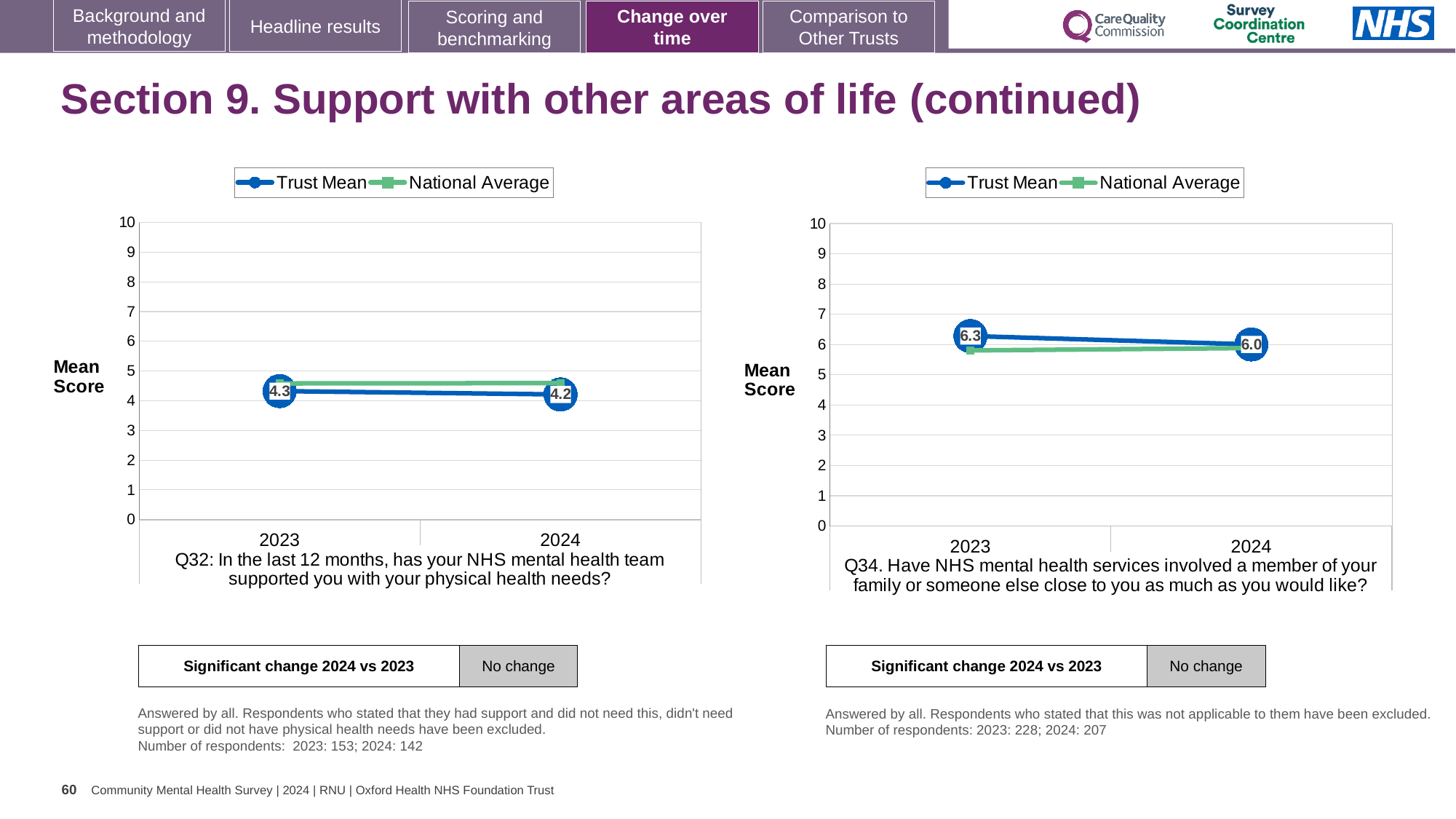
What kind of chart is the Q32 chart on the left? line chart How many years are shown on the x axis of the Q32 chart on the left? 2 In the Q34 chart on the right, by how much did the Trust Mean change from 2023 to 2024? 0.3 How many series does the legend of the Q34 chart on the right list? 2 In the Q34 chart on the right, is the National Average for 2023 greater or less than 7? less In the Q32 chart on the left, what is the Trust Mean for 2024? 4.2 In the Q32 chart on the left, what is the Trust Mean for 2023? 4.3 In the Q34 chart on the right, what is the Trust Mean for 2023? 6.3 In the Q34 chart on the right, which year has the higher Trust Mean? 2023 In the Q32 chart on the left, does the Trust Mean rise or fall from 2023 to 2024? fall In the Q32 chart on the left, is the National Average for 2023 higher or lower than the Trust Mean for 2023? higher In the Q34 chart on the right, what is the Trust Mean for 2024? 6.0